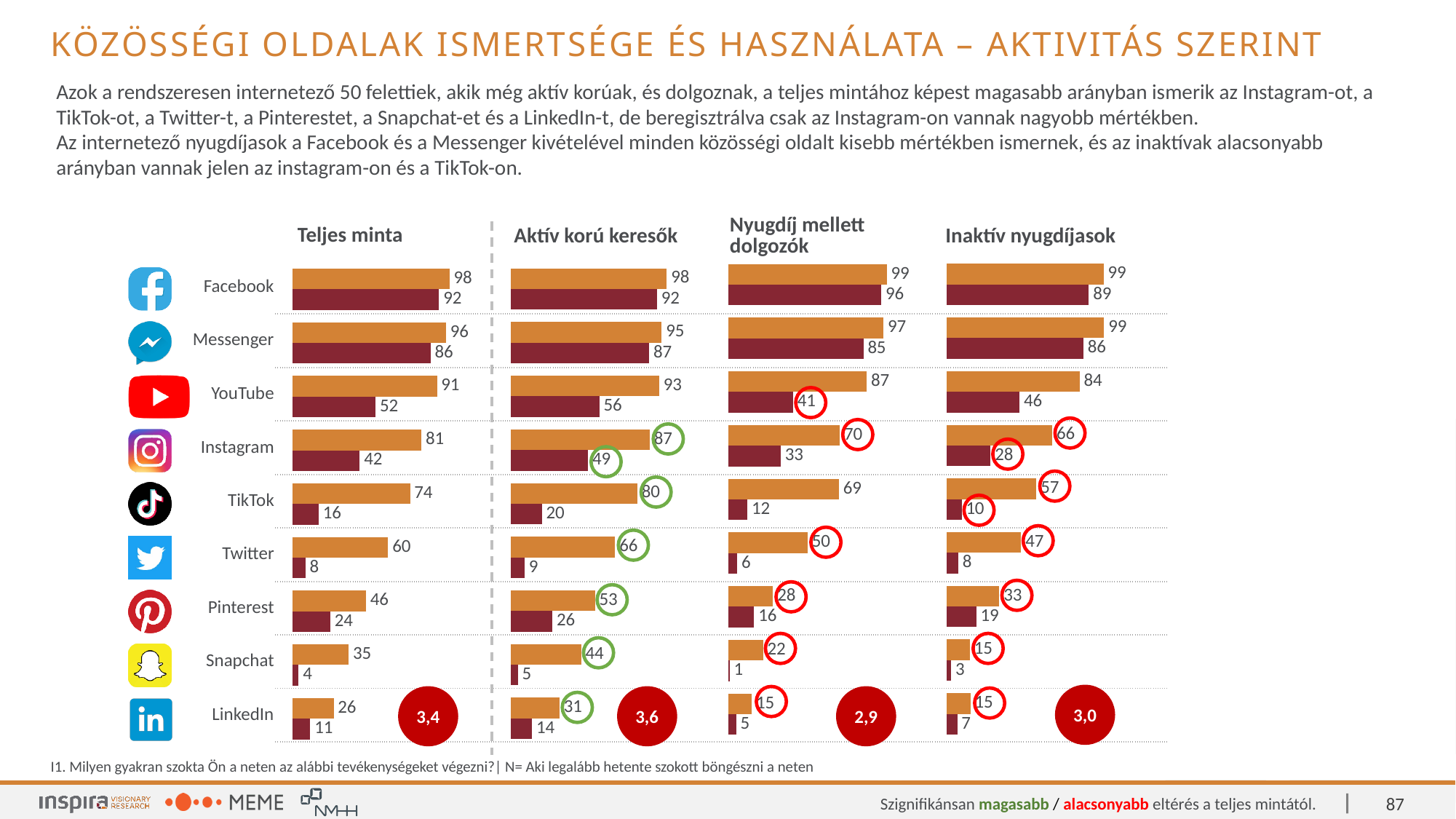
In the "Inaktív nyugdíjasok" chart, what is the value of the dark red bar for Facebook? 89 In the "Teljes minta" chart, what is the value of the orange bar for Instagram? 81 What kind of chart is used to show the data on this slide? Bar chart In the "Teljes minta" chart, which category has the lowest orange bar value? LinkedIn How many categories (social platforms) are shown in each chart? 9 Is the orange bar value for Twitter larger in the "Aktív korú keresők" chart or in the "Inaktív nyugdíjasok" chart? Aktív korú keresők What is the title of the chart on the far right of the slide? Inaktív nyugdíjasok In the "Nyugdíj mellett dolgozók" chart, what is the value of the orange bar for TikTok? 69 In the "Inaktív nyugdíjasok" chart, which category has the highest dark red bar value? Facebook In the "Aktív korú keresők" chart, what is the difference between the orange and dark red bar values for Instagram? 38 In the "Aktív korú keresők" chart, what is the value of the dark red bar for YouTube? 56 In the "Nyugdíj mellett dolgozók" chart, what is the difference between the orange bar values for Facebook and Snapchat? 77